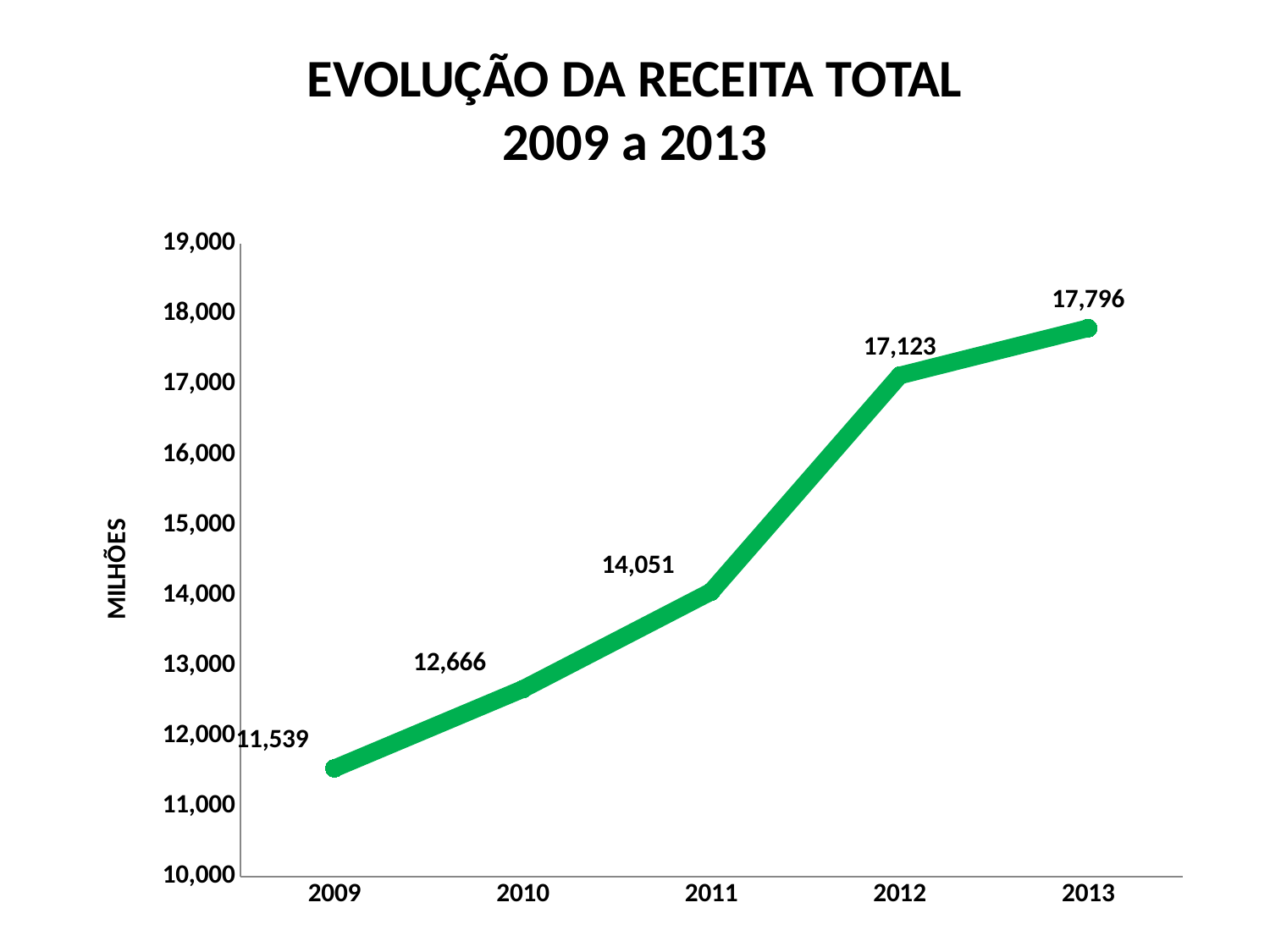
How many years are plotted on the chart? 5 What is the value for 2013? 17,796 Which year has the lowest value? 2009 What is the difference between the values for 2012 and 2011? 3,072 What kind of chart is shown? line chart Which year has the highest value? 2013 Is the value for 2011 greater or less than 15,000? less What is the difference between the values for 2013 and 2009? 6,257 Do the values rise or fall from 2009 to 2013? rise What is the value for 2009? 11,539 What is the value for 2011? 14,051 Which is larger, the value for 2010 or the value for 2012? 2012